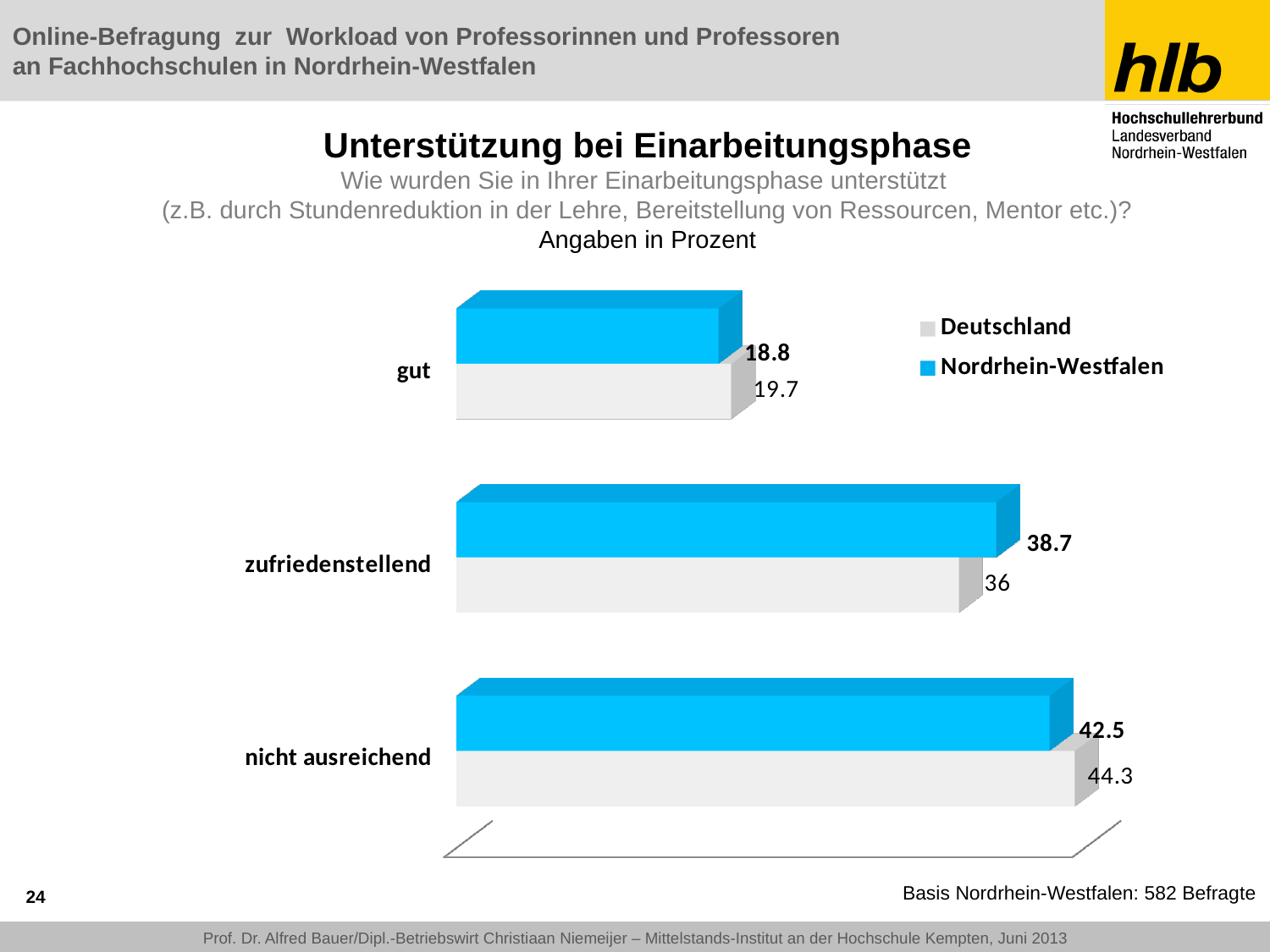
In the 'gut' category, which series has the larger value, Deutschland or Nordrhein-Westfalen? Deutschland What is the difference between the Deutschland and Nordrhein-Westfalen values in the 'nicht ausreichend' category? 1.8 How many categories are shown in the chart? 3 What is the value for Nordrhein-Westfalen in the 'gut' category? 18.8 How many series does the legend list? 2 What is the value for Deutschland in the 'nicht ausreichend' category? 44.3 What is the difference between the Deutschland and Nordrhein-Westfalen values in the 'zufriedenstellend' category? 2.7 What is the value for Nordrhein-Westfalen in the 'nicht ausreichend' category? 42.5 Which category has the lowest value for Deutschland? gut What is the value for Deutschland in the 'zufriedenstellend' category? 36 Which category has the highest value for Nordrhein-Westfalen? nicht ausreichend What kind of chart is shown on the slide? bar chart